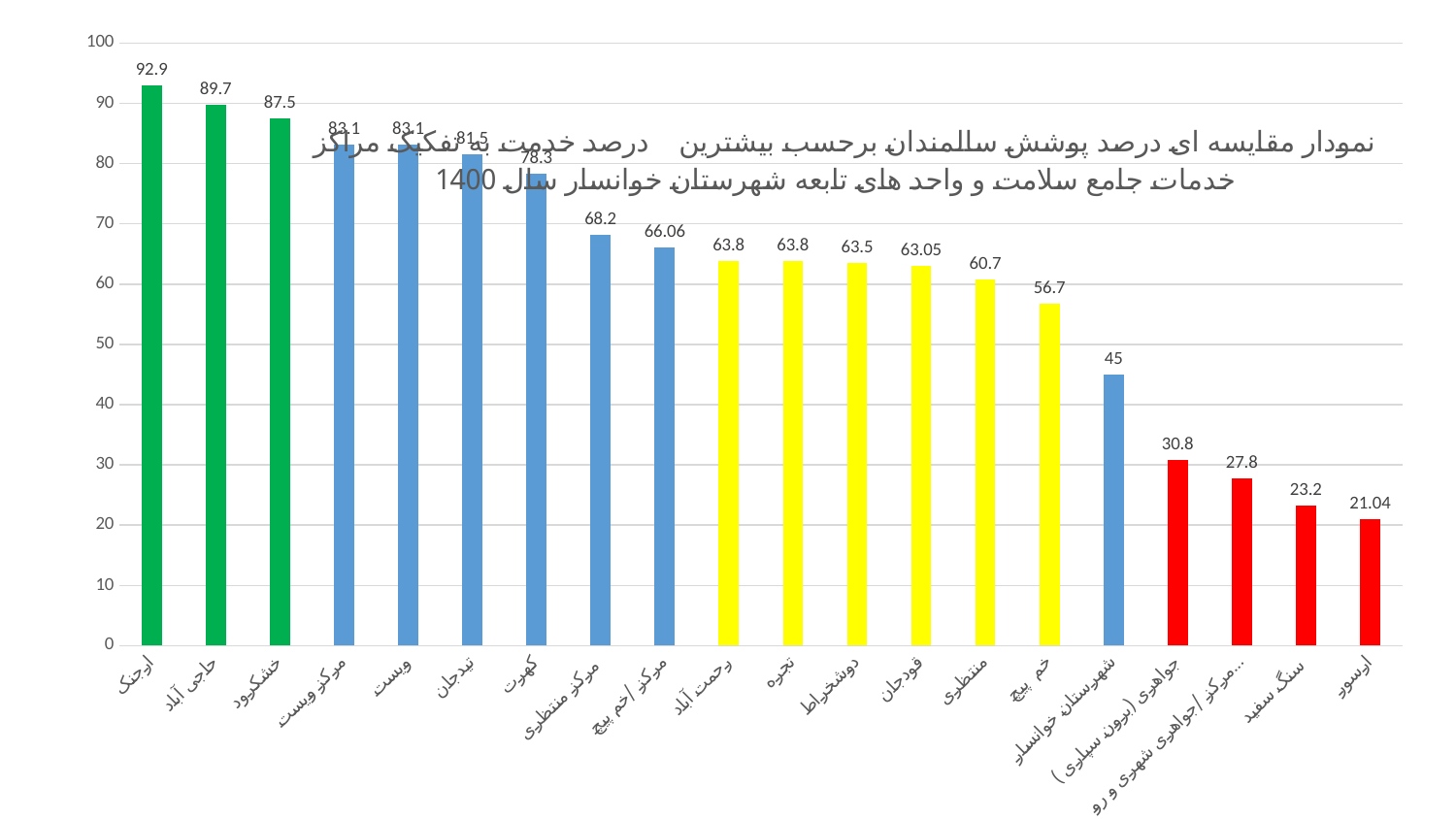
Which category has the lowest value? ارسور What is the value for ارجنک? 92.9 What is the value for شهرستان خوانسار? 45 What type of chart is shown on the slide? bar chart What is the difference between the values for ارجنک and حاجی آباد? 3.2 What colour are the three leftmost bars? green What is the value for خم پیچ? 56.7 How many bars (categories) are plotted in the chart? 20 Do the values generally rise or fall from left to right along the x axis? fall Which is larger, the value for سنگ سفید or the value for جواهری (برون سپاری)? جواهری (برون سپاری) Which category has the highest value? ارجنک